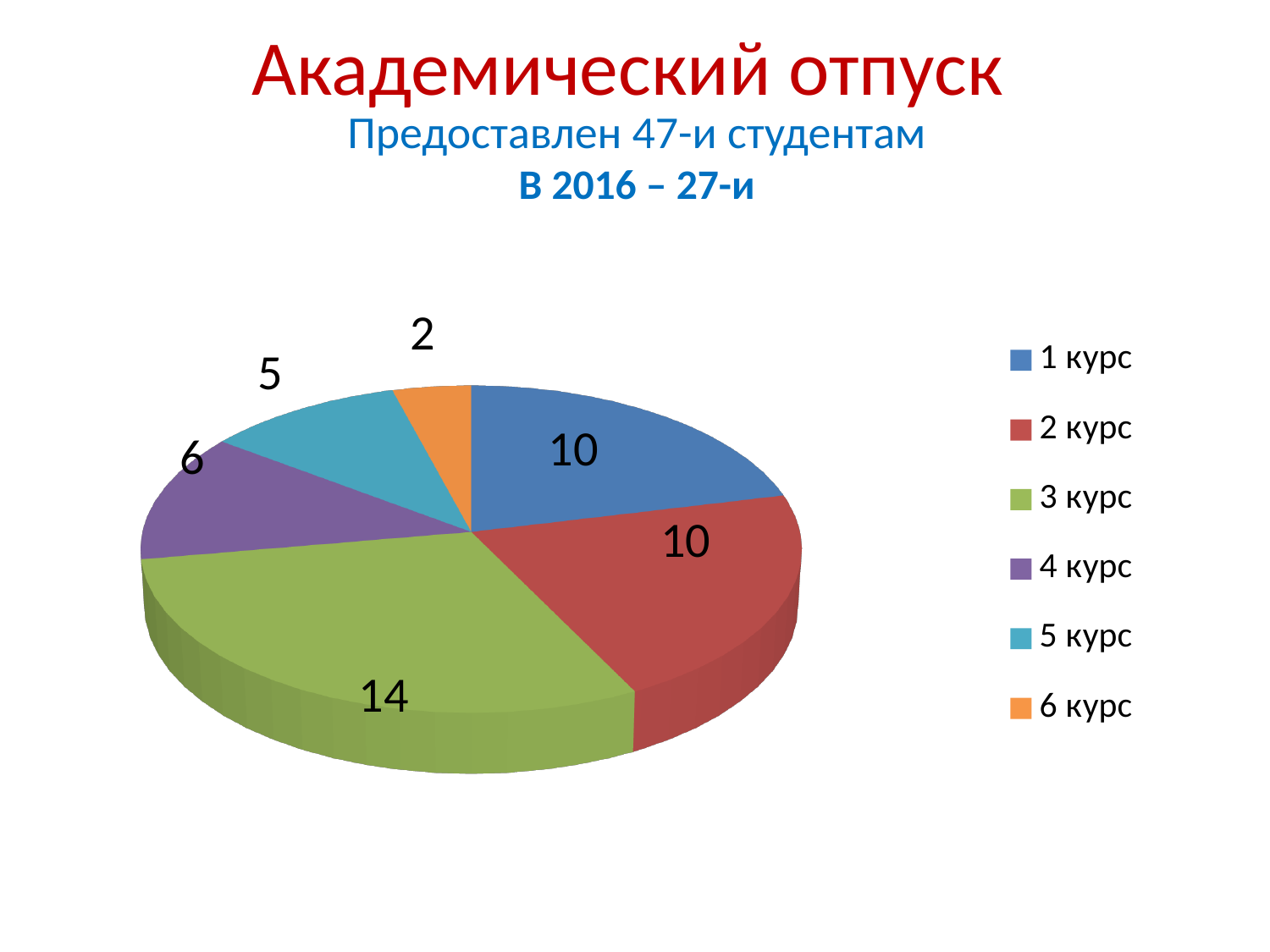
What is the difference between the values for 3 курс and 4 курс? 8 How many entries does the legend list? 6 Which course has the largest slice? 3 курс What is the value for 3 курс? 14 What colour is the slice for 3 курс? green What is the value for 4 курс? 6 Which is larger, the value for 4 курс or 5 курс? 4 курс What type of chart is shown on the slide? pie chart What is the value for 6 курс? 2 What is the total of all slices in the pie chart? 47 Which course has the smallest slice? 6 курс How many slices does the pie chart have? 6